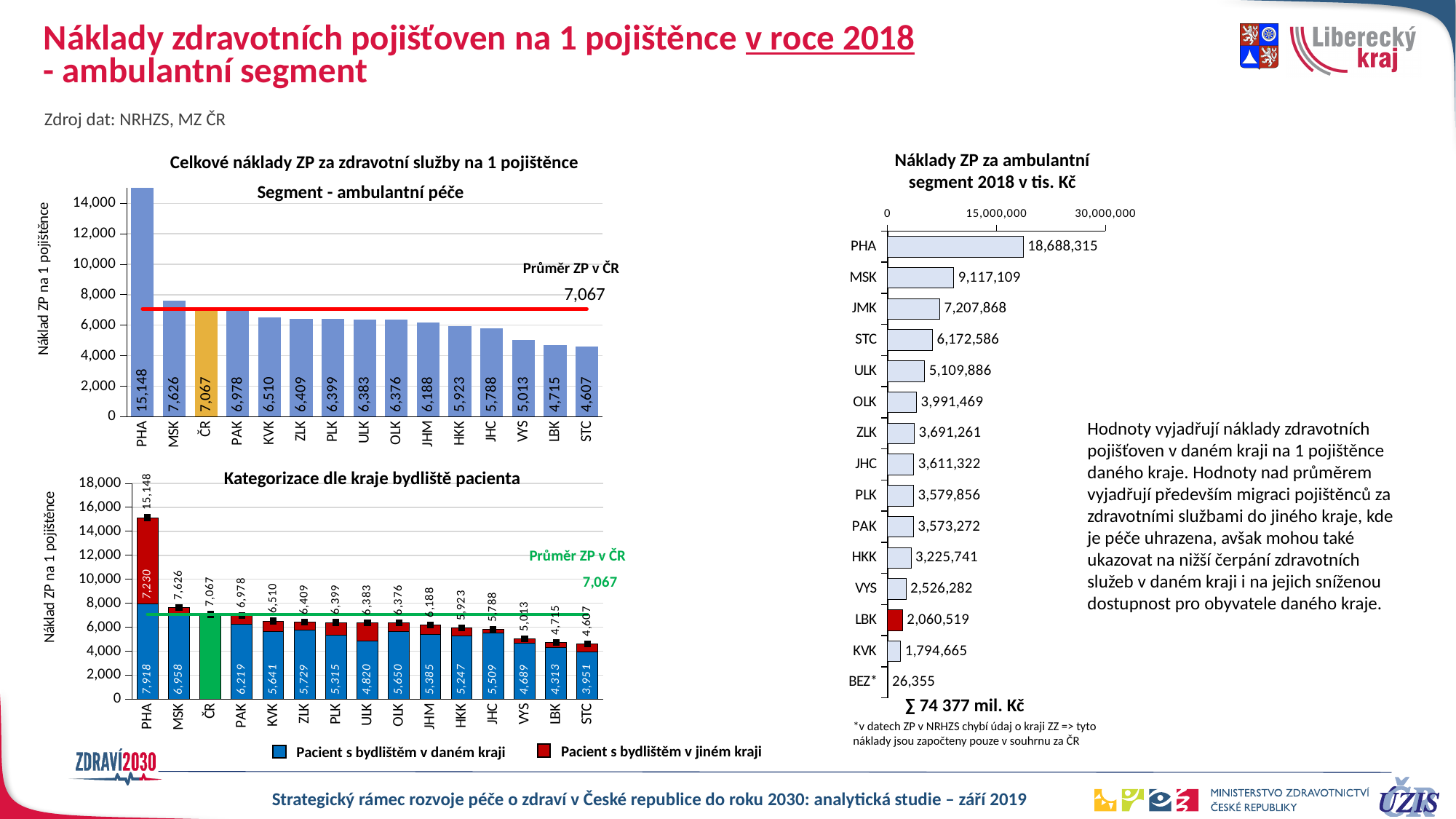
In the chart 'Kategorizace dle kraje bydliště pacienta', what is the value for 'Pacient s bydlištěm v jiném kraji' for PHA? 7,230 What kind of chart is 'Náklady ZP za ambulantní segment 2018 v tis. Kč'? Bar chart In the chart 'Kategorizace dle kraje bydliště pacienta', how many series does the legend list? 2 In the chart 'Celkové náklady ZP za zdravotní služby na 1 pojištěnce', what is the difference between the values for MSK and PAK? 648 In the chart 'Kategorizace dle kraje bydliště pacienta', what is the value for 'Pacient s bydlištěm v daném kraji' for PHA? 7,918 In the chart 'Náklady ZP za ambulantní segment 2018 v tis. Kč', what is the value for LBK? 2,060,519 In the chart 'Celkové náklady ZP za zdravotní služby na 1 pojištěnce', what is the value of the 'Průměr ZP v ČR' line? 7,067 In the chart 'Celkové náklady ZP za zdravotní služby na 1 pojištěnce', which category has the highest value? PHA In the chart 'Celkové náklady ZP za zdravotní služby na 1 pojištěnce', what is the value for LBK? 4,715 In the chart 'Náklady ZP za ambulantní segment 2018 v tis. Kč', which is larger, the value for JMK or the value for STC? JMK In the chart 'Náklady ZP za ambulantní segment 2018 v tis. Kč', how many categories are shown? 15 In the chart 'Celkové náklady ZP za zdravotní služby na 1 pojištěnce', which category has the lowest value? STC